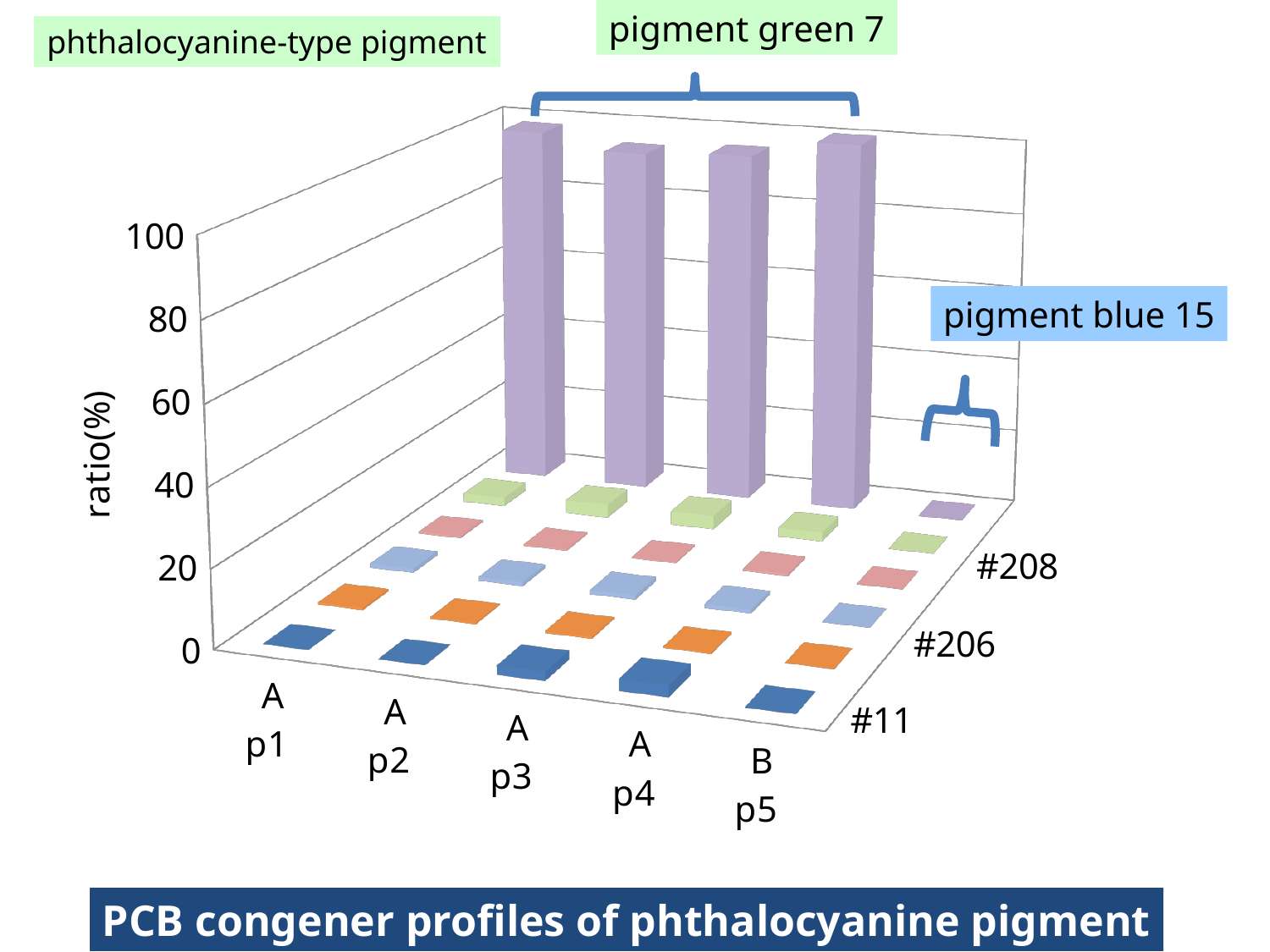
Which sample has the lowest value in the back-row (purple) series? B p5 Is the value of the tallest (purple, back-row) bar for A p1 greater or less than 60? greater How many sample categories are shown along the x axis of the chart? 5 Is the value of the back-row (purple) bar for B p5 greater or less than 40? less Which samples are labelled as pigment green 7 on the chart? A p1, A p2, A p3, A p4 For A p2, which is larger: the back-row (purple) bar or the #11 bar? the back-row (purple) bar What is the title of the y axis of the chart? ratio(%) What is the title shown beneath the chart? PCB congener profiles of phthalocyanine pigment Is the value of the #11 bar for A p1 greater or less than 20? less What kind of chart is shown on the slide? bar chart